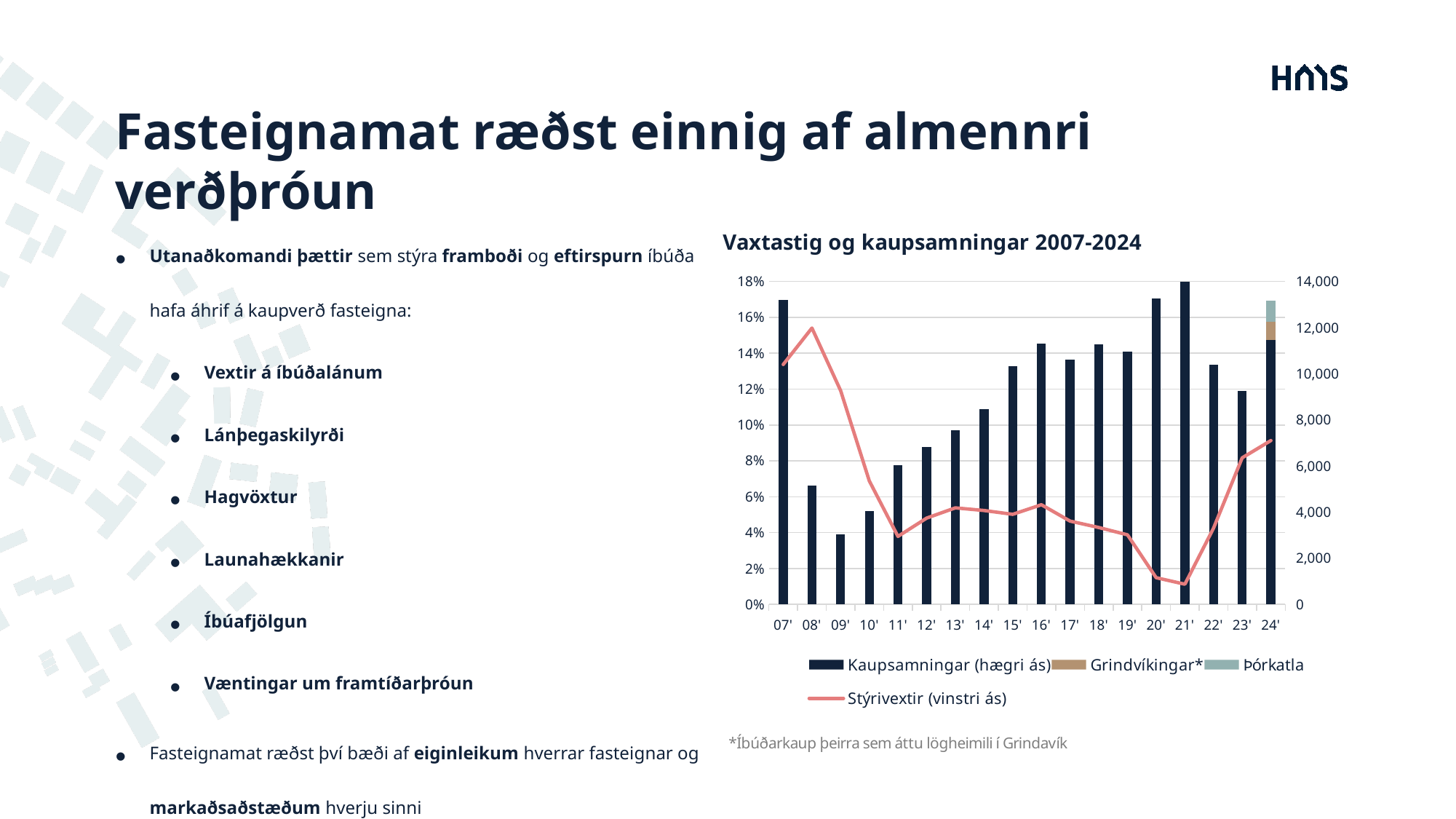
Is the Stýrivextir value for 08' greater or less than 14%? greater In which year does the Stýrivextir line reach its highest point? 08' Is the Kaupsamningar value for 21' greater or less than 12,000? greater Does the Stýrivextir line rise or fall from 08' to 11'? It falls How many series does the legend of the chart list? 4 Which year has the larger Kaupsamningar bar, 07' or 08'? 07' What kind of chart is shown under the title 'Vaxtastig og kaupsamningar 2007-2024'? A combined bar and line chart Is the Stýrivextir value for 21' greater or less than 2%? less How many years are shown on the x axis of the chart? 18 In which year is the Kaupsamningar bar the lowest? 09' In which year is the Kaupsamningar bar the highest? 21'